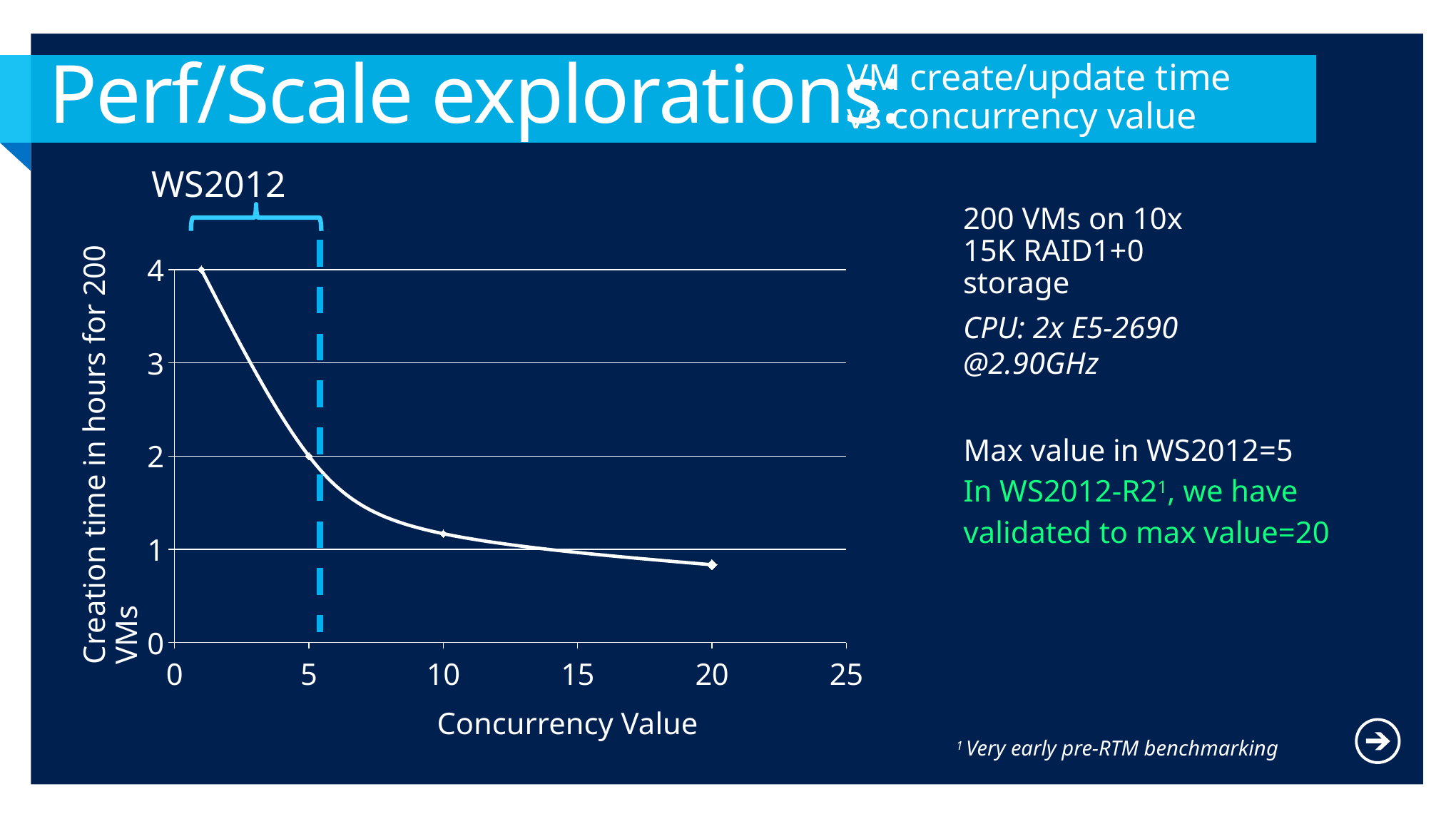
How many data points are plotted on the chart? 4 What kind of chart is shown on the slide? line chart Is the creation time at a concurrency value of 10 greater or less than 1 hour? greater Is the creation time at a concurrency value of 10 greater or less than 2 hours? less Which concurrency value has the lowest creation time? 20 What is the creation time in hours at a concurrency value of 5? 2 Does the creation time rise or fall as the concurrency value increases? fall What is the title of the x axis? Concurrency Value Which has the larger creation time: concurrency value 5 or concurrency value 20? concurrency value 5 Is the creation time at a concurrency value of 20 greater or less than 1 hour? less